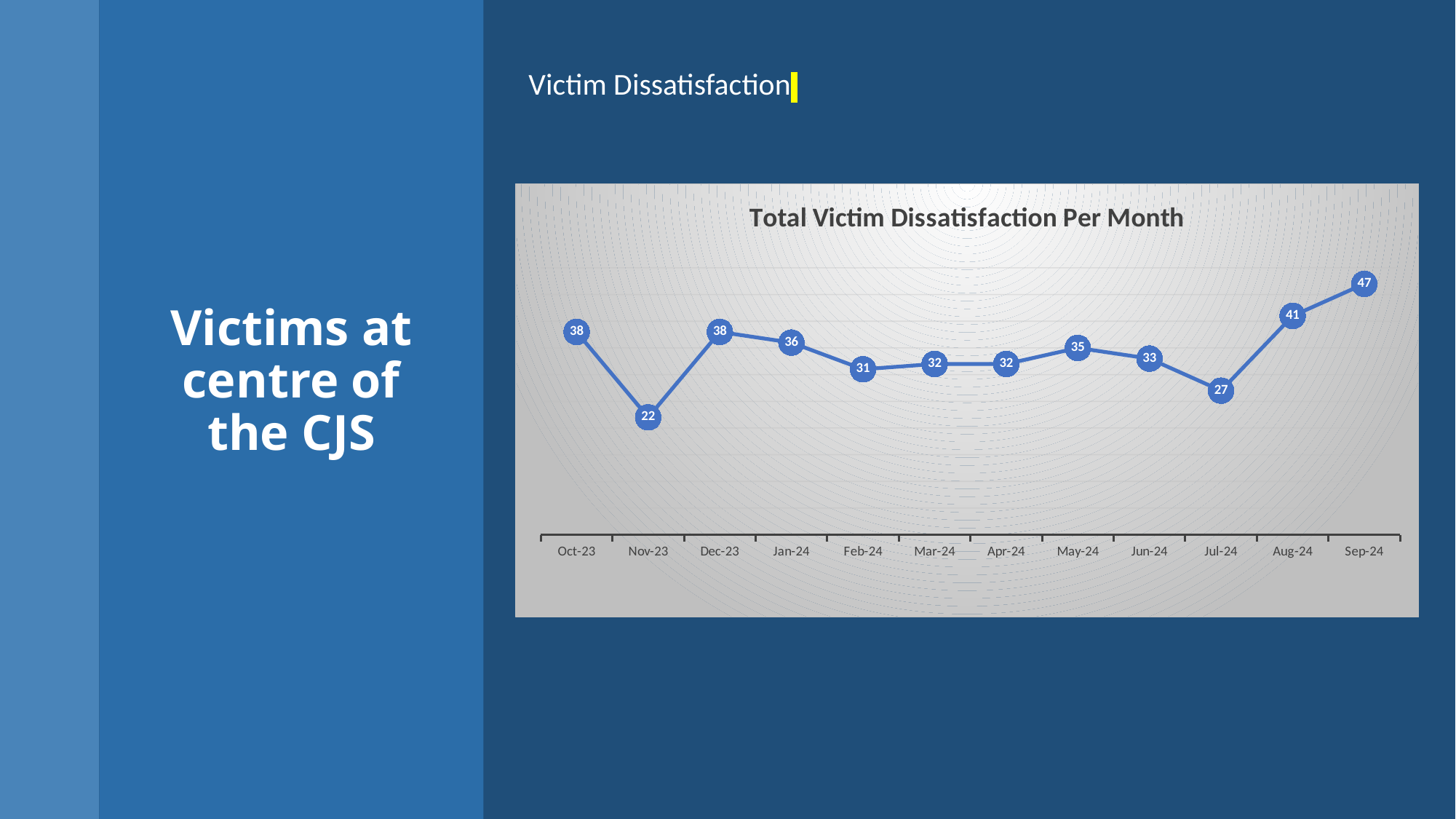
How many months are plotted on the chart? 12 Which month has the highest value? Sep-24 Which is larger, the value for Jan-24 or the value for Feb-24? Jan-24 What is the difference between the values for Aug-24 and Jul-24? 14 What is the title of the chart? Total Victim Dissatisfaction Per Month What is the value for May-24? 35 Which month has the lowest value? Nov-23 What is the value for Sep-24? 47 What is the value for Jul-24? 27 What is the difference between the values for Sep-24 and Nov-23? 25 What kind of chart is shown? Line chart What is the value for Nov-23? 22